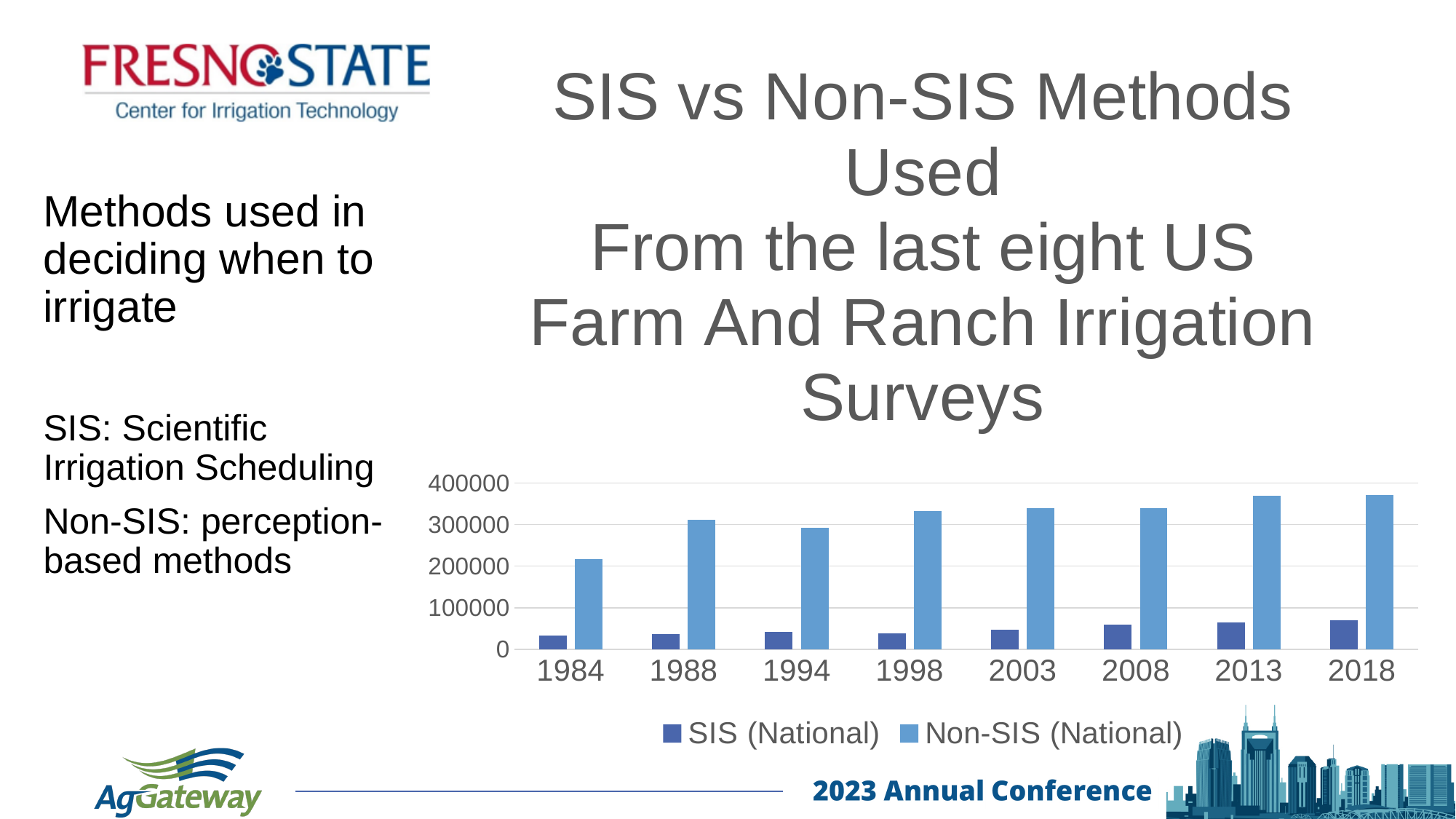
Which year has the lowest Non-SIS (National) value? 1984 Which year has the larger Non-SIS (National) value, 1988 or 1994? 1988 Is the Non-SIS (National) value for 1984 greater or less than 200000? greater What are the two series named in the chart's legend? SIS (National) and Non-SIS (National) Which is larger in 2003, the SIS (National) value or the Non-SIS (National) value? Non-SIS (National) Is the SIS (National) value for 2018 greater or less than 100000? less Do the SIS (National) values generally rise or fall from 1998 to 2018? rise How many series does the chart's legend list? 2 What kind of chart is shown on the slide? bar chart How many survey years are shown on the x axis of the chart? 8 Is the Non-SIS (National) value for 2018 greater or less than 400000? less